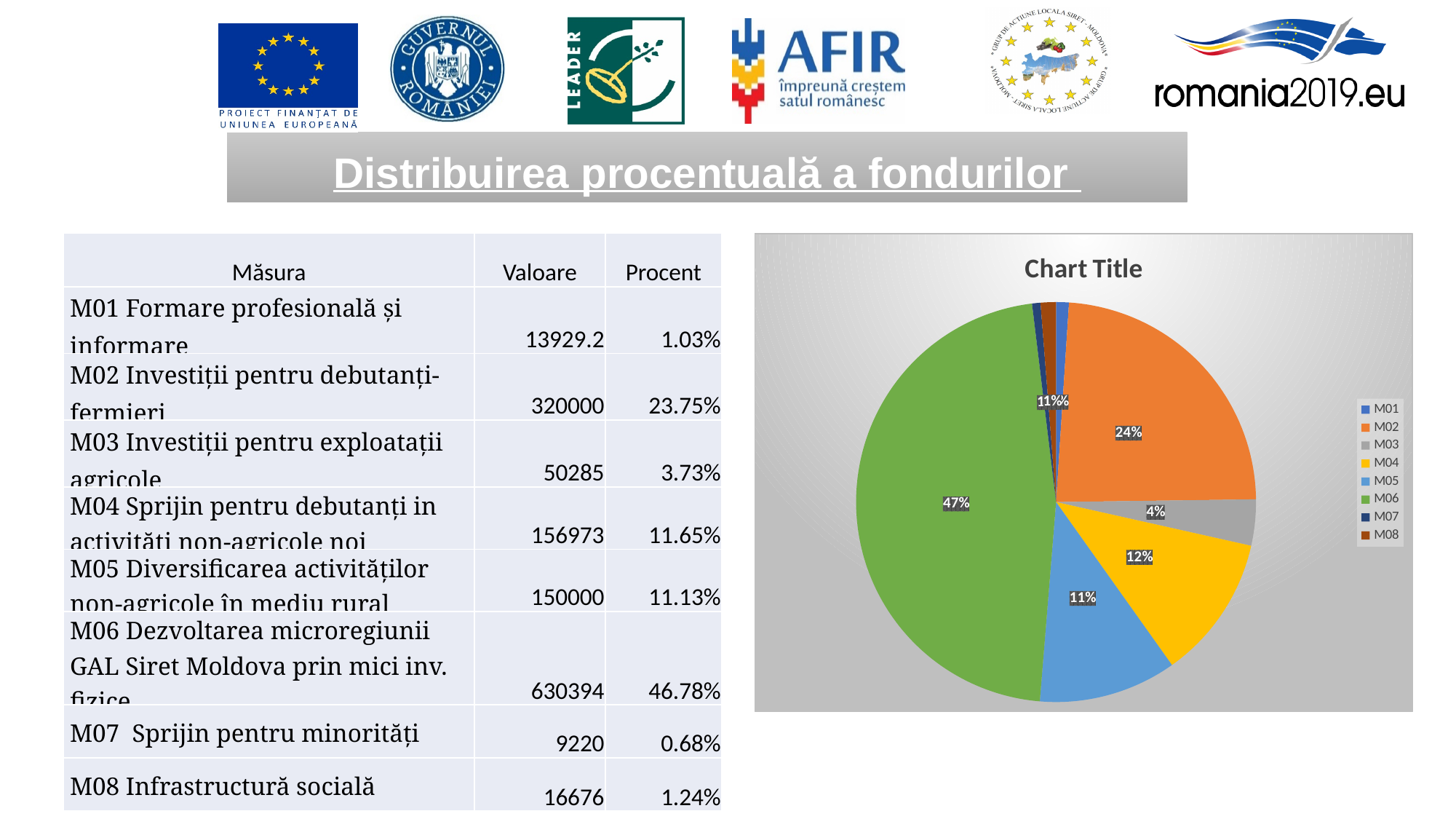
By how many percentage points does the M06 slice exceed the M02 slice, based on the data labels? 23 What is the data label shown on the M03 slice of the pie chart? 4% How many entries does the legend of the pie chart list? 8 Which measure has the largest slice in the pie chart? M06 What share of the pie does M02 have according to its data label? 24% Which slice is larger in the pie chart, M02 or M04? M02 What kind of chart is shown on the right of the slide? pie chart What is the data label shown on the M05 slice of the pie chart? 11% What share of the pie does M06 have according to its data label? 47% Which slice is larger in the pie chart, M03 or M05? M05 What is the data label shown on the M04 slice of the pie chart? 12% What title is displayed above the pie chart? Chart Title